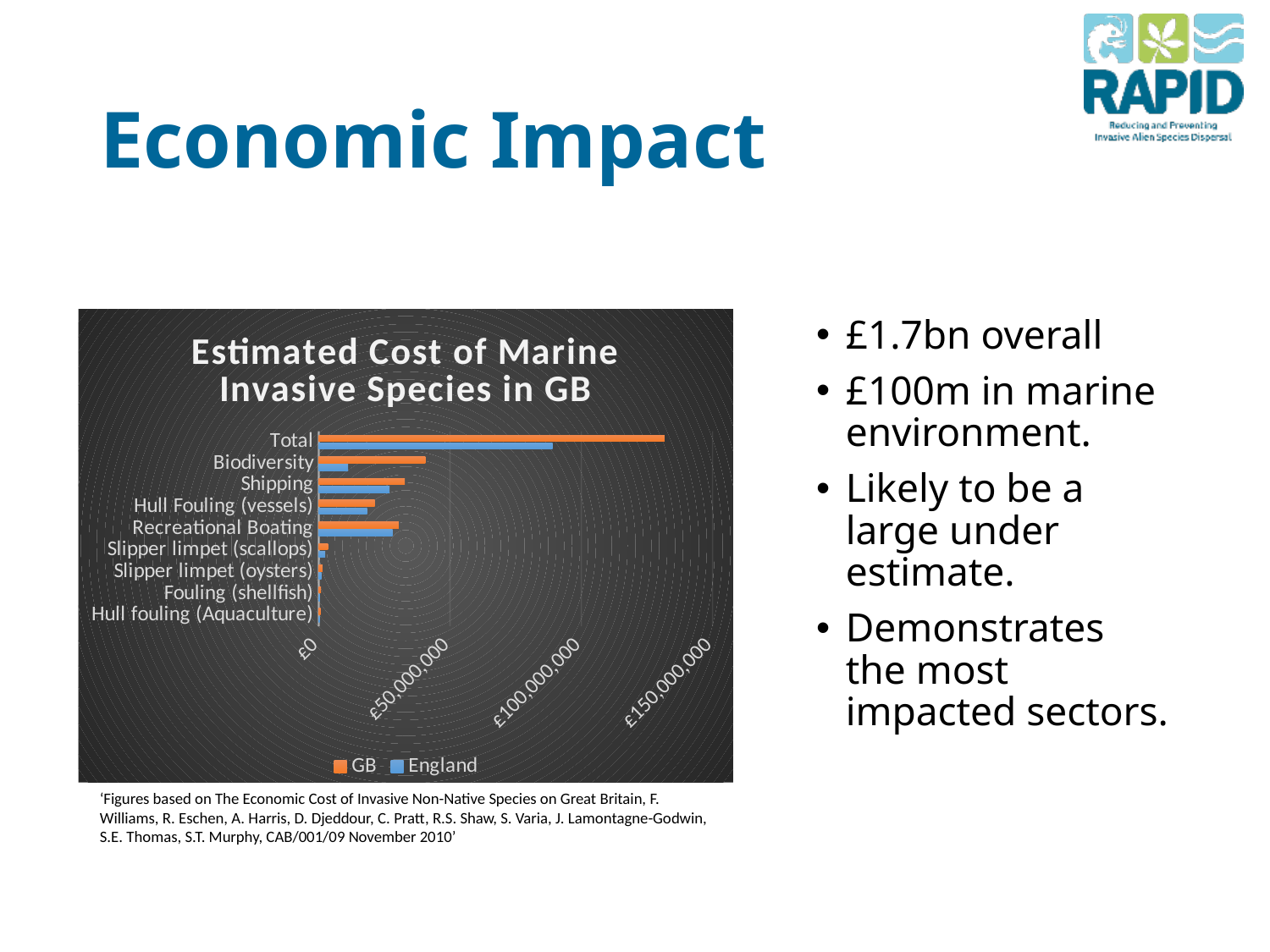
Is the GB value for Total greater or less than £100,000,000? greater What type of chart is shown on the slide? Bar chart For Biodiversity, which series has the larger value, GB or England? GB Is the England value for Total greater or less than £100,000,000? less For the England series, which is larger: Biodiversity or Shipping? Shipping For the GB series, which is larger: Biodiversity or Shipping? Biodiversity How many series does the chart legend list? 2 What is the title of the chart? Estimated Cost of Marine Invasive Species in GB Which colour represents the GB series in the chart? Orange How many categories are shown on the chart's vertical axis? 9 Is the GB value for Biodiversity greater or less than £50,000,000? less Which category has the highest GB value in the chart? Total